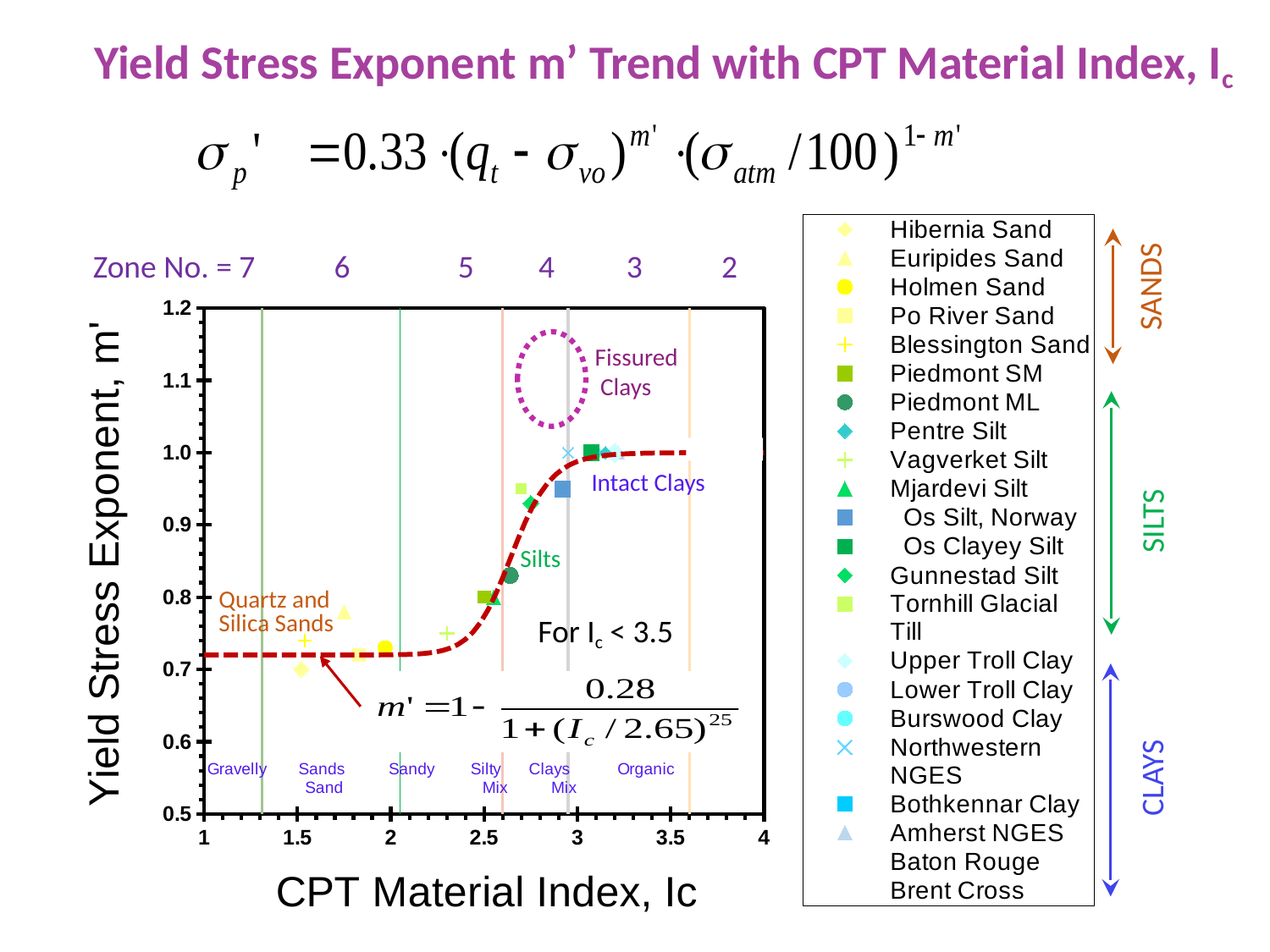
What kind of chart is shown on the slide? Scatter chart What is the label of the x axis of the chart? CPT Material Index, Ic Which has a larger value of m': Os Clayey Silt or Hibernia Sand? Os Clayey Silt Is the value of m' for Os Clayey Silt greater or less than 0.9? greater Is the value of m' for Piedmont ML greater or less than 0.9? less Into how many material groups (shown by the arrows beside the legend) are the legend entries divided? 3 How many zone numbers are labelled above the chart? 6 Is the value of m' for Holmen Sand greater or less than 0.8? less What is the label of the y axis of the chart? Yield Stress Exponent, m' Does the yield stress exponent m' generally rise or fall as the CPT Material Index Ic increases along the x axis? Rise